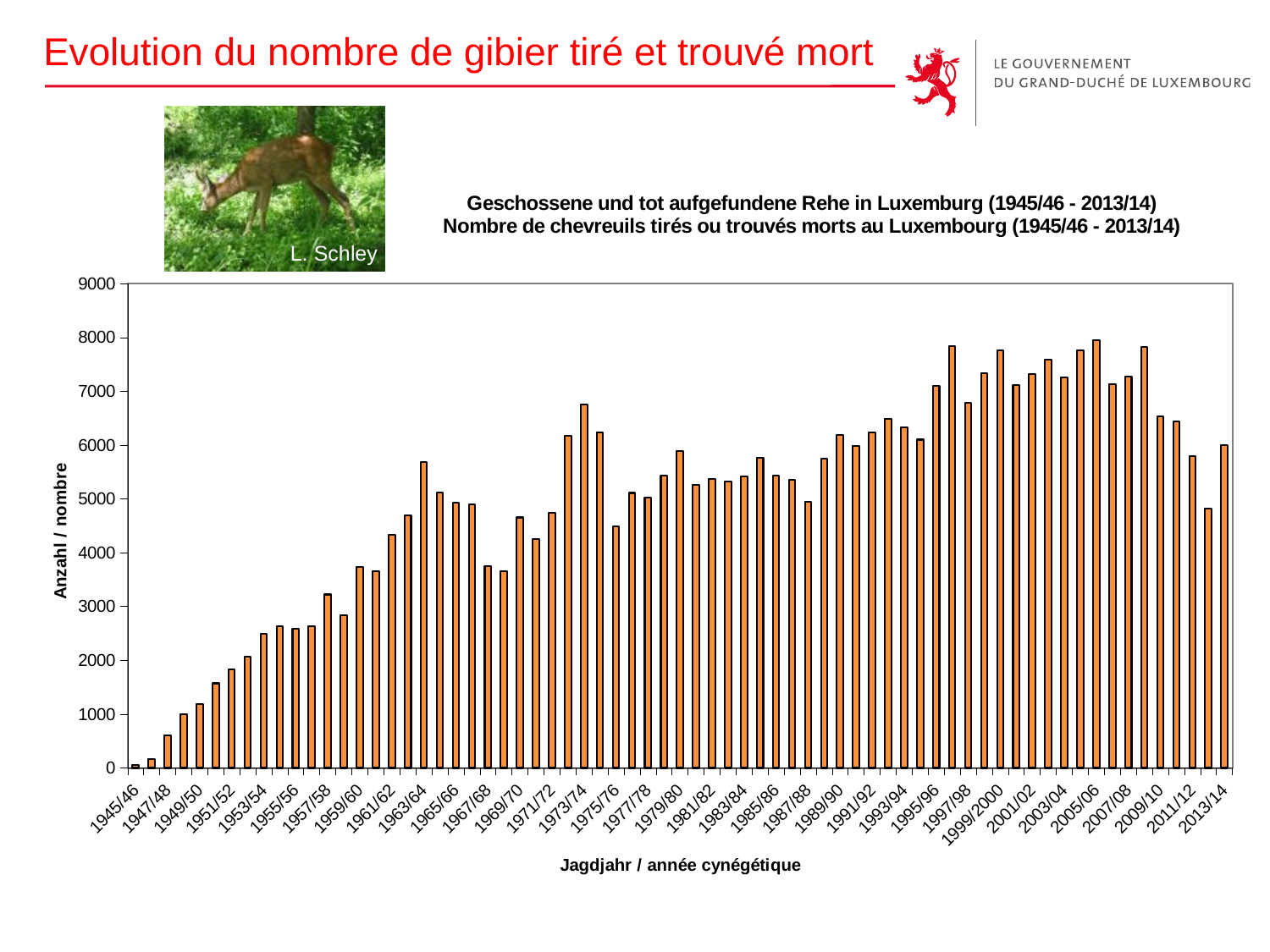
What is the label of the vertical axis? Anzahl / nombre What kind of chart is shown on the slide? bar chart Is the value for 1975/76 greater or less than 5000? less Is the value for 1957/58 greater or less than 3000? greater Is the value for 1997/98 greater or less than 7000? less Which hunting year has the lowest number of roe deer shot or found dead? 1945/46 Which is larger, the value for 1973/74 or the value for 1975/76? 1973/74 Overall, do the values rise or fall from 1945/46 to the late 1990s? rise What is the label of the horizontal axis? Jagdjahr / année cynégétique